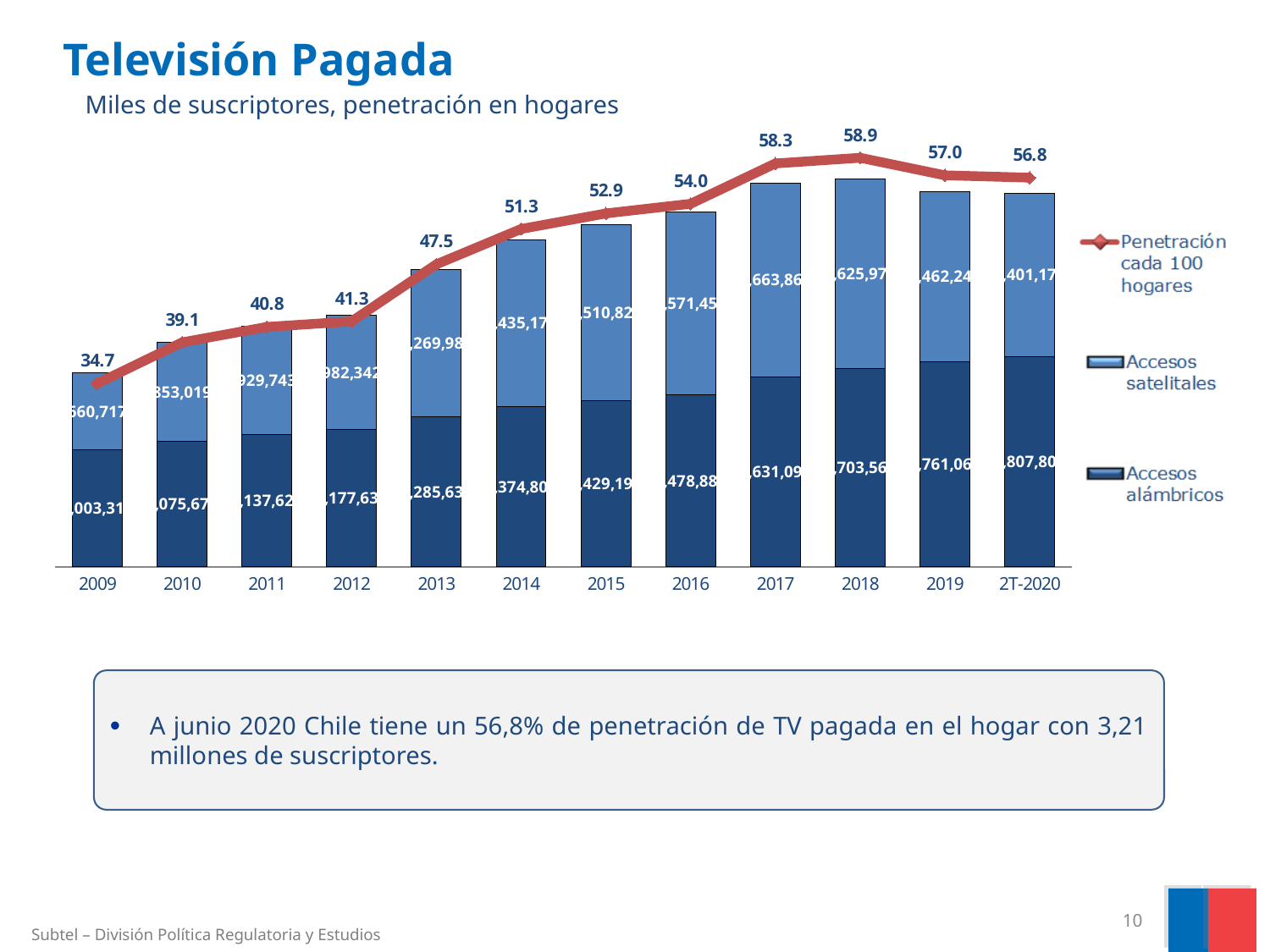
In which year is Penetración cada 100 hogares lowest? 2009 What is the difference in Penetración cada 100 hogares between 2017 and 2016? 4.3 How many years (categories) are shown on the x axis? 12 What is the value of Penetración cada 100 hogares for 2014? 51.3 What is the difference in Penetración cada 100 hogares between 2018 and 2009? 24.2 How many series does the legend list? 3 What is the value of Penetración cada 100 hogares for 2009? 34.7 What kind of chart is shown on the slide? Stacked bar chart with a line Which year has a higher Penetración cada 100 hogares, 2013 or 2015? 2015 Does Penetración cada 100 hogares rise or fall from 2009 to 2018? Rise In which year is Penetración cada 100 hogares highest? 2018 What is the value of Penetración cada 100 hogares for 2T-2020? 56.8